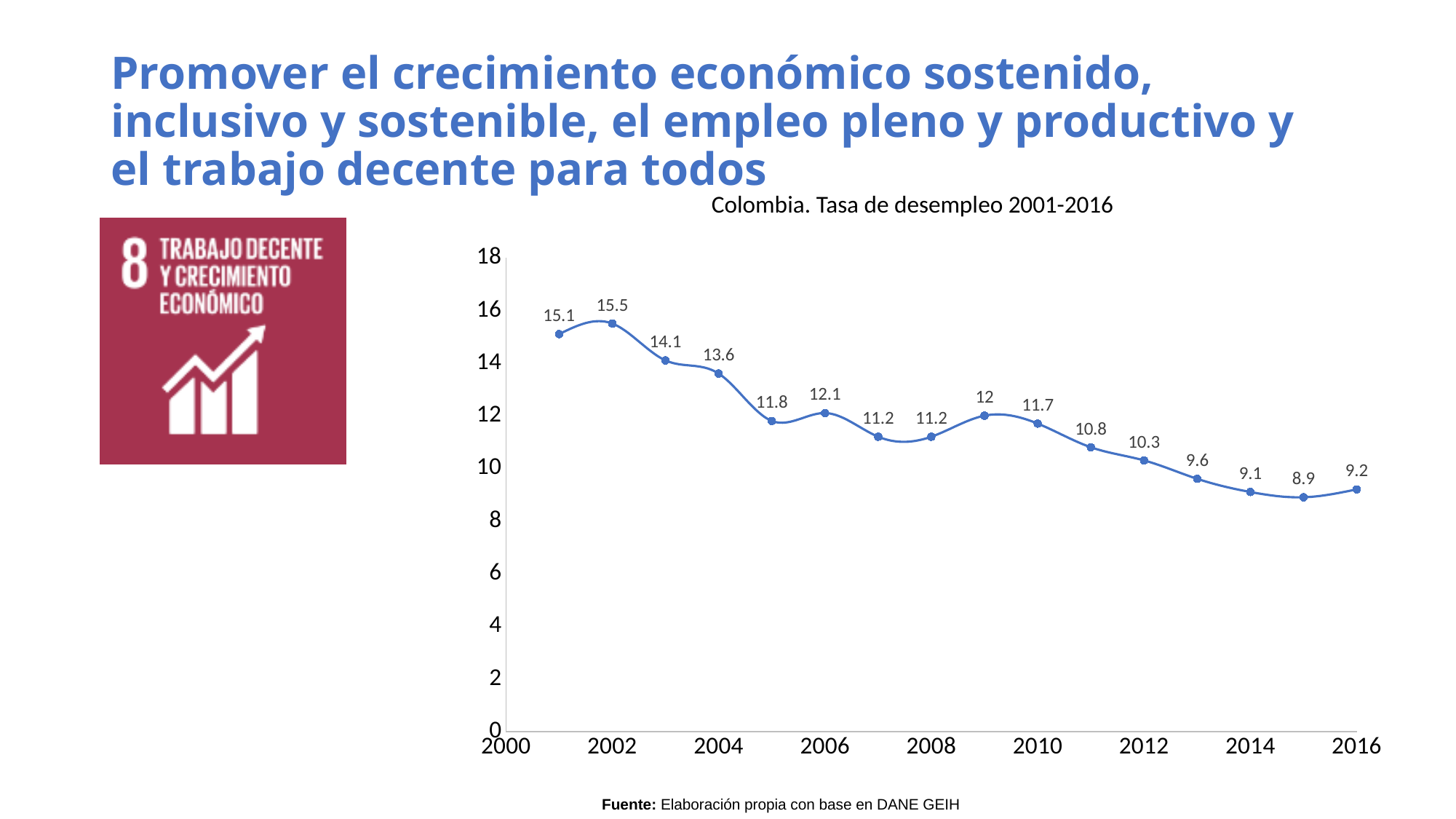
Which year has the highest unemployment rate on the chart? 2002 What value is plotted for 2016? 9.2 Which year has the higher value, 2005 or 2006? 2006 What kind of chart is shown on the slide? line chart What is the unemployment rate shown for 2002? 15.5 Is the value for 2013 greater or less than 10? less How many data points are plotted on the chart? 16 What is the difference between the values for 2001 and 2016? 5.9 Do the values generally rise or fall from 2001 to 2016? fall What is the value shown for 2009? 12 What is the title of the chart? Colombia. Tasa de desempleo 2001-2016 Which year has the lowest unemployment rate on the chart? 2015